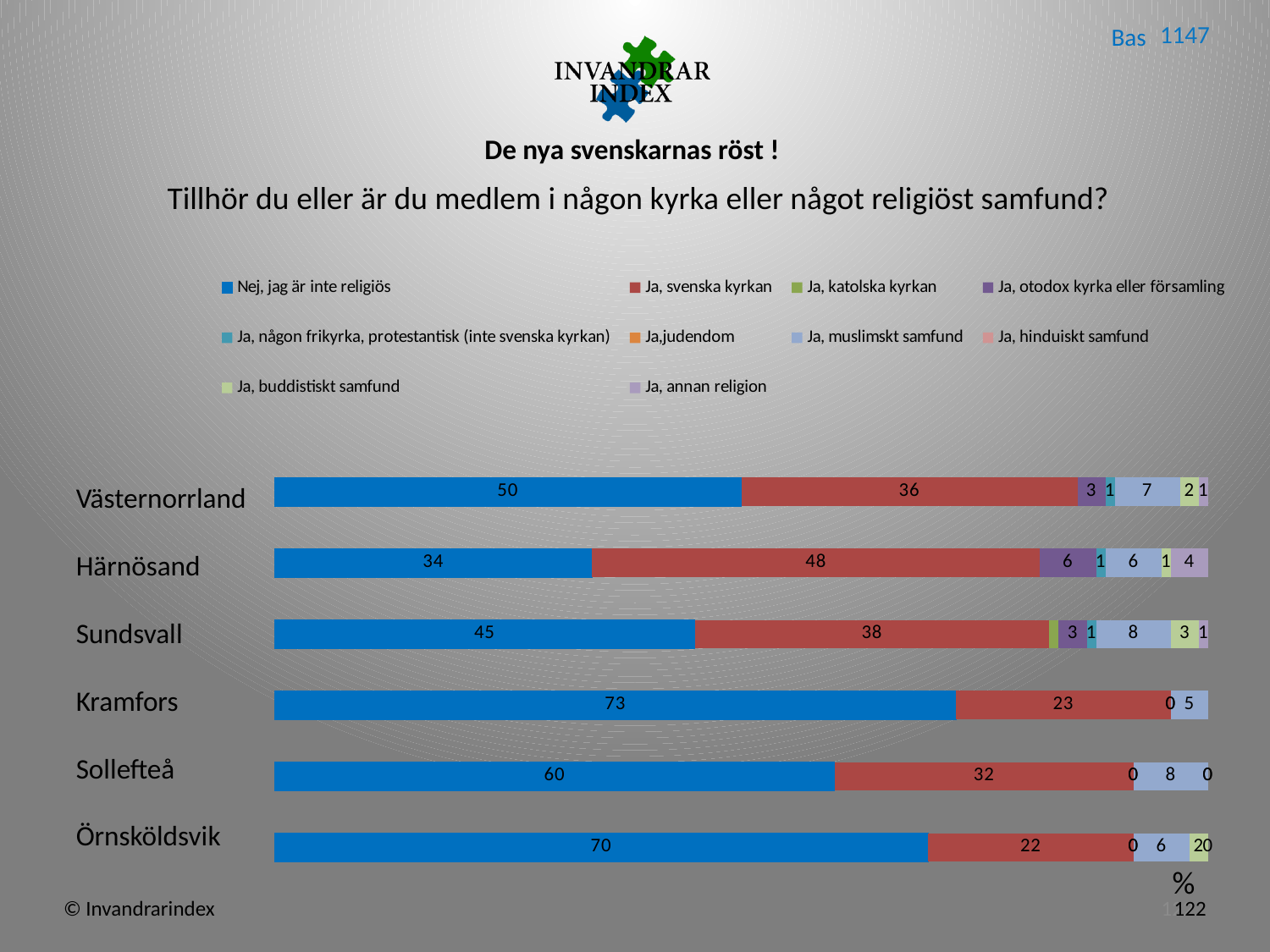
How many series does the legend list? 10 What is the difference between the 'Nej, jag är inte religiös' values for Örnsköldsvik and Västernorrland? 20 What is the value for 'Ja, svenska kyrkan' for Härnösand? 48 What kind of chart is shown on the slide? stacked bar chart Which category has the highest value for 'Ja, svenska kyrkan'? Härnösand What is the value for 'Nej, jag är inte religiös' for Kramfors? 73 What is the value for 'Ja, muslimskt samfund' for Sundsvall? 8 What is the 'Bas' (base) number shown in the top right corner of the slide? 1147 How many regions/municipalities are listed on the chart? 6 Which is larger: the 'Ja, svenska kyrkan' value for Sundsvall or for Sollefteå? Sundsvall Which category has the highest value for 'Nej, jag är inte religiös'? Kramfors Which category has the lowest value for 'Nej, jag är inte religiös'? Härnösand